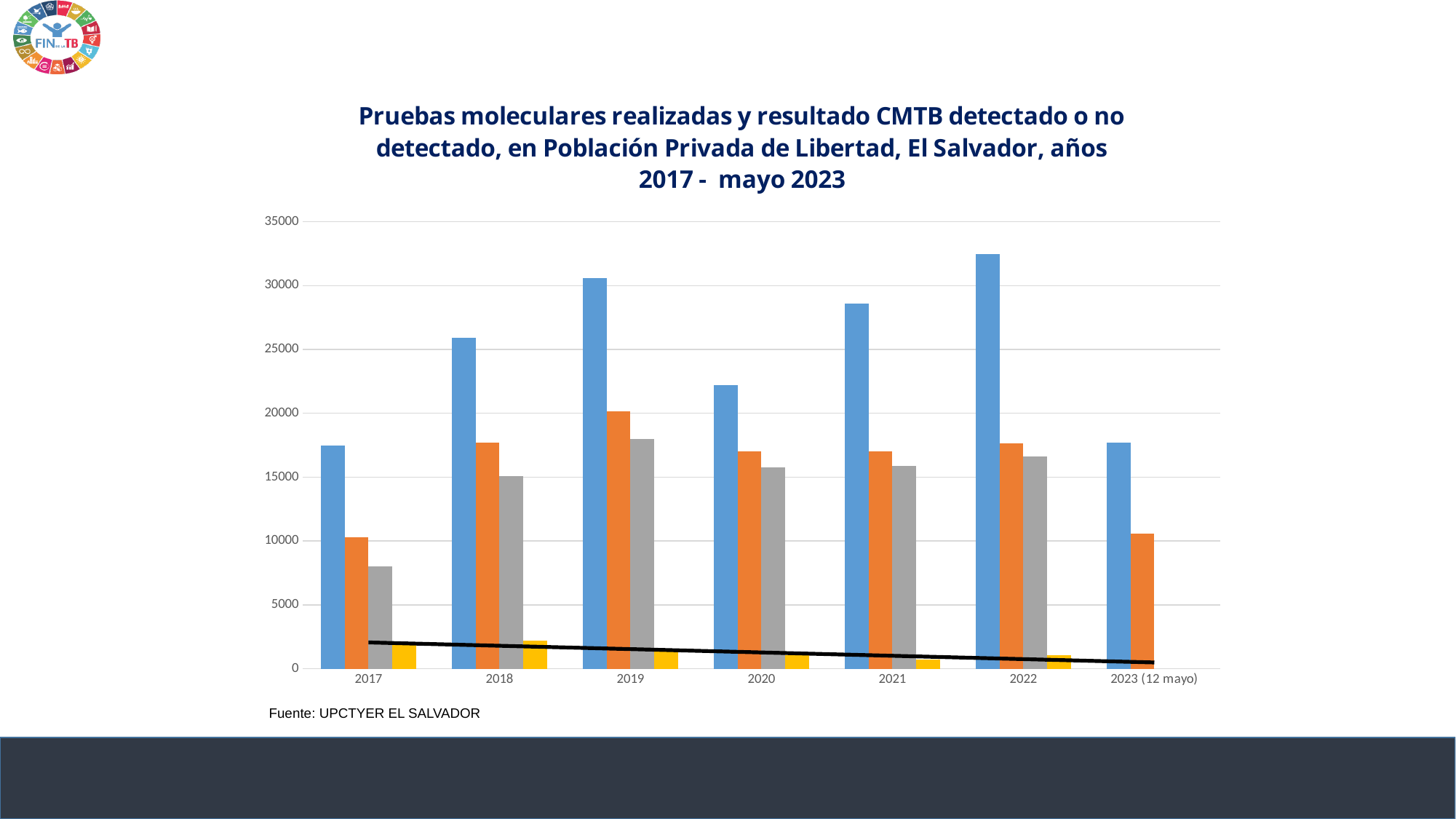
How many year categories are shown on the x axis? 7 In which year is the blue bar the tallest? 2022 In which year is the gray bar the shortest? 2017 What kind of chart is shown on the slide? bar chart Is the value of the blue bar for 2020 greater or less than 25000? less Which is larger, the blue bar for 2018 or the blue bar for 2019? 2019 Is the value of the blue bar for 2019 greater or less than 30000? greater In which year is the orange bar the tallest? 2019 What source is cited below the chart? UPCTYER EL SALVADOR Is the value of the gray bar for 2017 greater or less than 10000? less Does the black trend line rise or fall from 2017 to 2023? fall